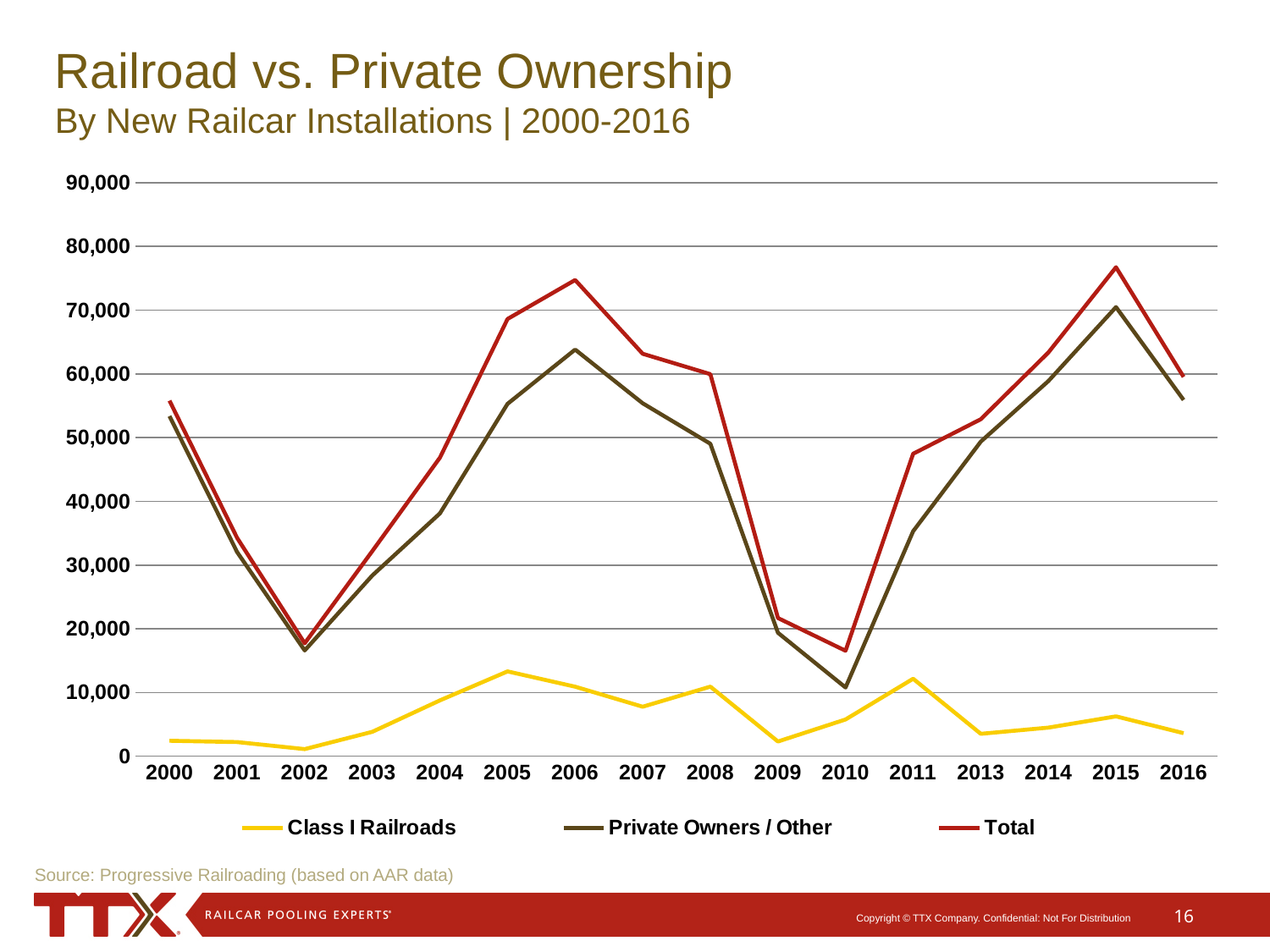
Is the Class I Railroads value for 2005 greater or less than 10,000? greater How many series does the legend list? 3 Is the Total value for 2006 greater or less than 70,000? greater Which is larger for Private Owners / Other: the value in 2004 or the value in 2007? 2007 In which year does the Private Owners / Other series reach its highest value? 2015 What kind of chart is shown on the slide? Line chart Which series is drawn in red? Total In which year does the Total series reach its highest value? 2015 Is the Total value for 2010 greater or less than 20,000? less Does the Total series rise or fall from 2008 to 2010? Fall How many years are shown on the x axis? 16 In which year does the Private Owners / Other series reach its lowest value? 2010